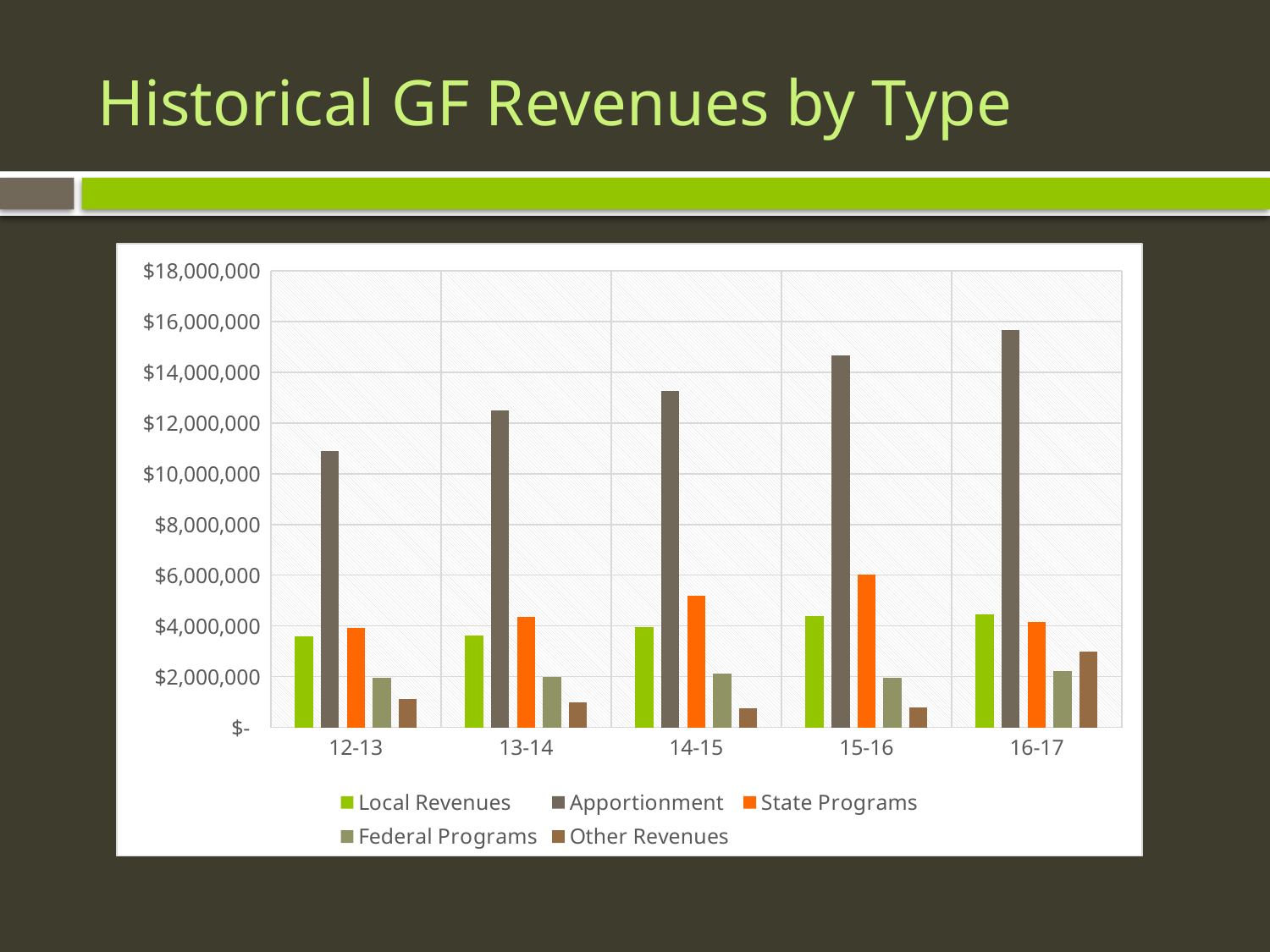
Which is larger, State Programs in 15-16 or State Programs in 16-17? 15-16 In which year is Other Revenues highest? 16-17 How many series does the legend list? 5 Is the State Programs value for 15-16 greater or less than $4,000,000? greater In which year is Apportionment highest? 16-17 Is the Apportionment value for 12-13 greater or less than $10,000,000? greater Is the Apportionment value for 16-17 greater or less than $16,000,000? less Does Apportionment rise or fall from 12-13 to 16-17? rises How many fiscal years are shown on the x axis? 5 What kind of chart is shown on the slide? bar chart Which series has the lowest value in 12-13? Other Revenues What colour represents State Programs in the legend? orange